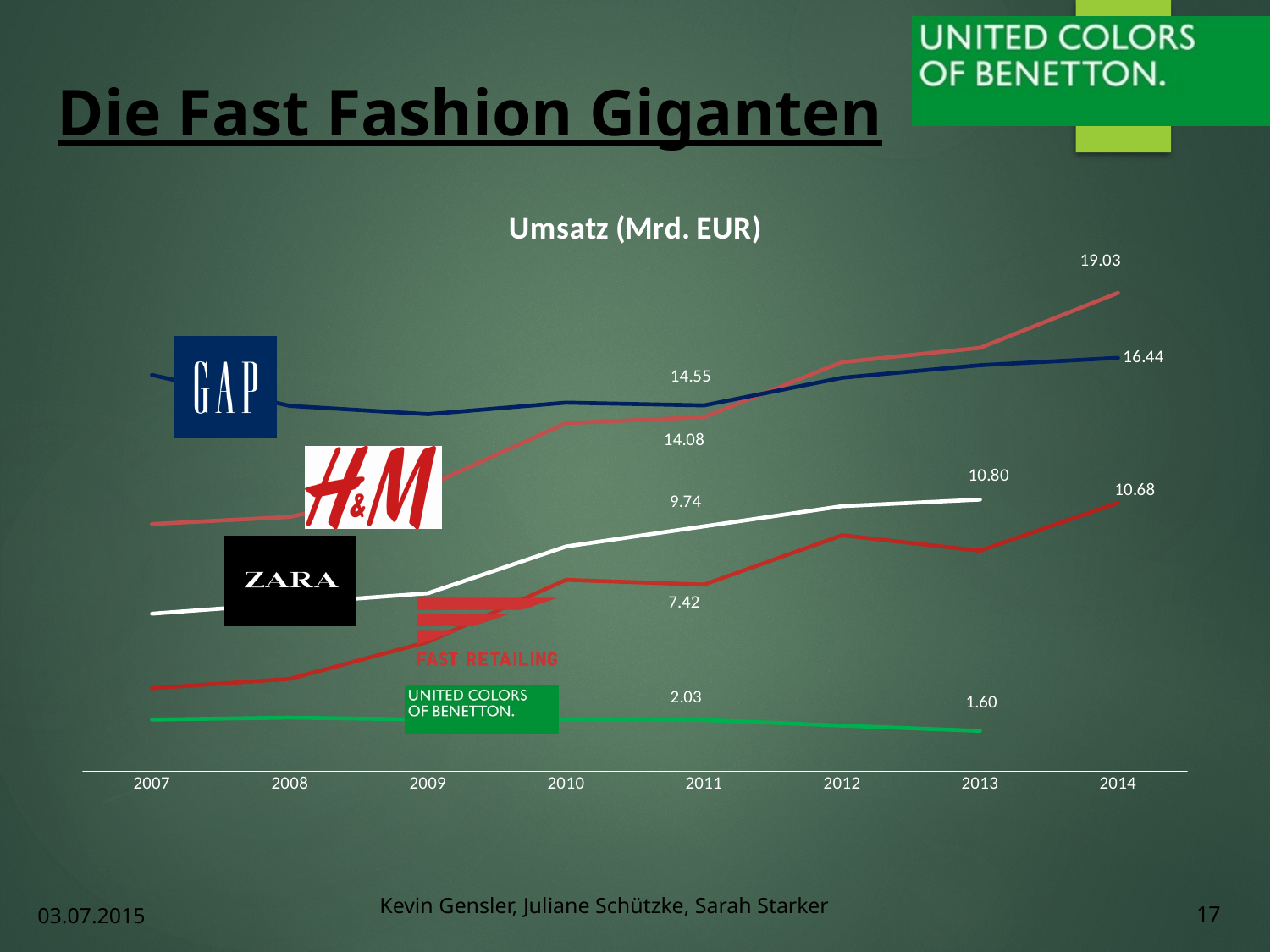
What is the value labelled for H&M in 2014? 19.03 How many years are shown on the x axis of the chart? 8 What is the value labelled for GAP in 2011? 14.55 What is the difference between the 2014 values of H&M (19.03) and GAP (16.44)? 2.59 What is the value labelled for GAP in 2014? 16.44 What is the value labelled for H&M in 2011? 14.08 Does the H&M line rise or fall from 2007 to 2014? rise What is the value labelled for United Colors of Benetton in 2013? 1.60 What is the value labelled for ZARA in 2013? 10.80 What kind of chart is shown on the slide? line chart What is the title of the chart? Umsatz (Mrd. EUR) Which company has the highest value in 2014? H&M